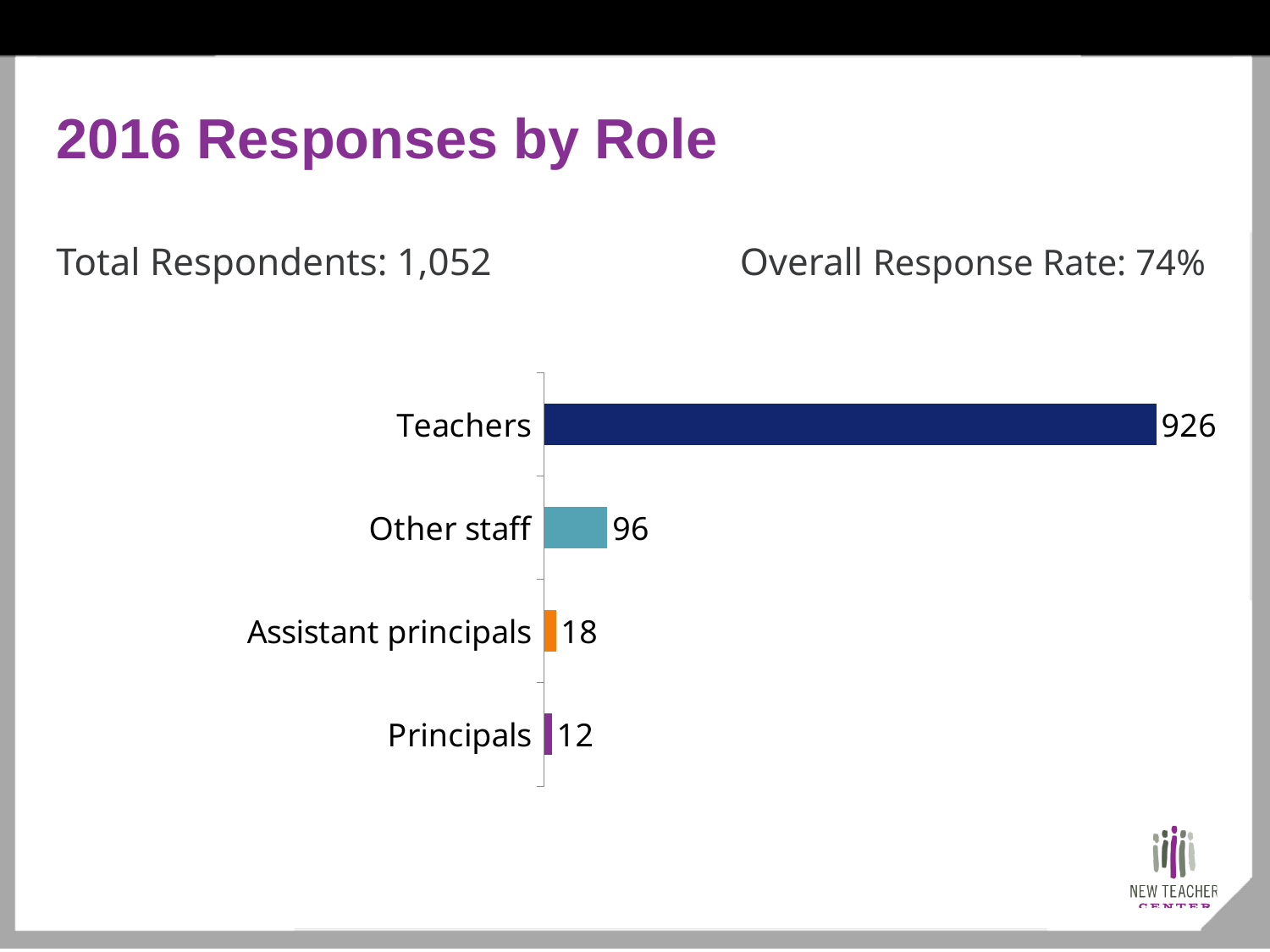
How many responses came from Principals? 12 What is the difference between the number of responses from Assistant principals and from Principals? 6 What is the difference between the number of responses from Teachers and from Other staff? 830 How many responses came from Assistant principals? 18 How many responses came from Teachers? 926 What kind of chart is shown on the slide? Bar chart What is the title of the slide containing the chart? 2016 Responses by Role Which role has the lowest number of responses? Principals Which has more responses, Other staff or Assistant principals? Other staff Which role has the highest number of responses? Teachers How many responses came from Other staff? 96 How many roles are shown in the chart? 4